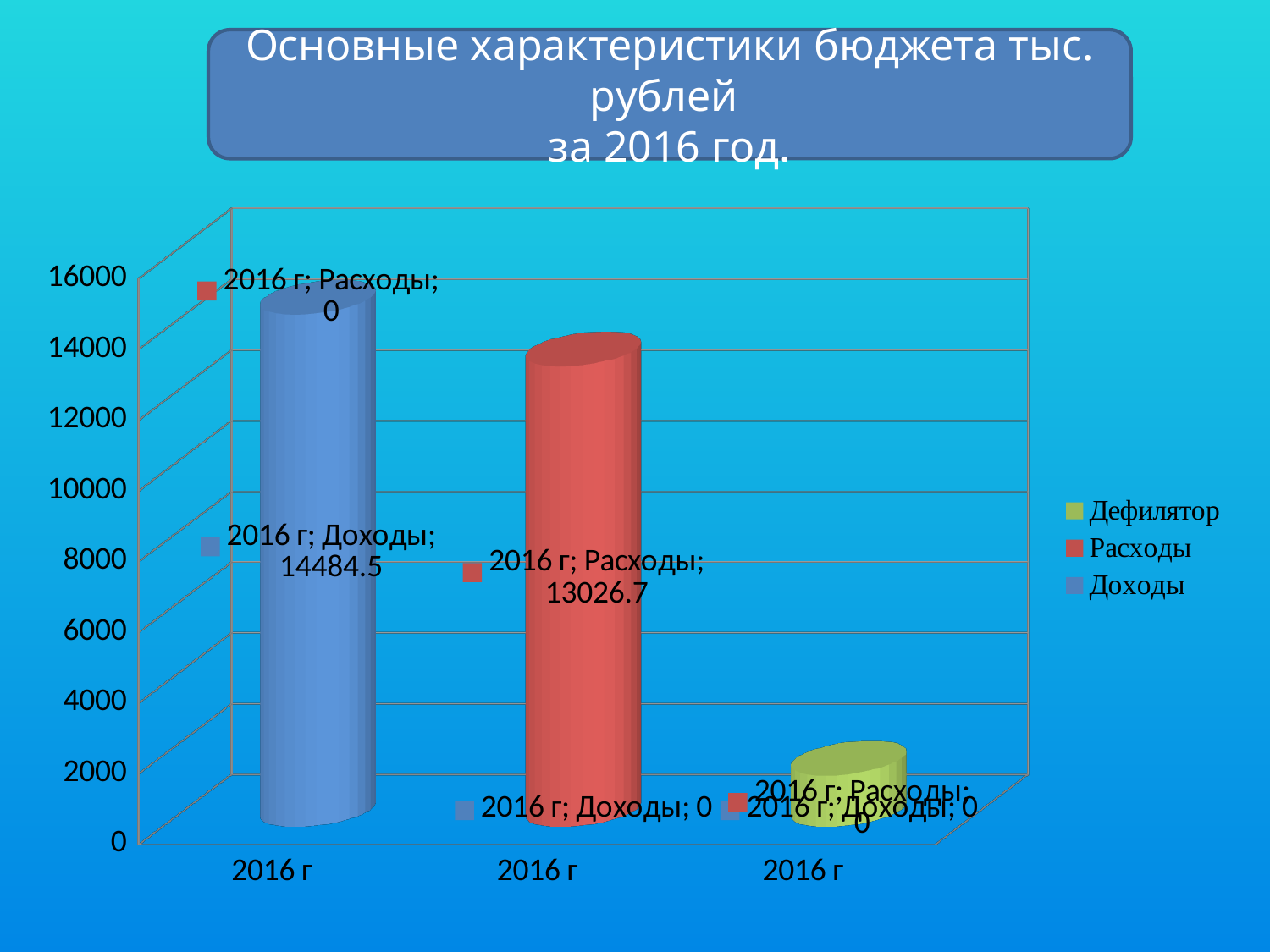
What is the difference between Доходы and Расходы for 2016 г? 1457.8 How many bars are plotted on the chart? 3 Is the value for Дефилятор greater or less than 2000? less How many series does the legend list? 3 What kind of chart is shown on the slide? bar chart Is the value for Расходы greater or less than 12000? greater Which is larger for 2016 г, Доходы or Расходы? Доходы What is the value of Расходы for 2016 г? 13026.7 Which series is shown in green in the legend? Дефилятор Which series has the lowest bar on the chart? Дефилятор What is the value of Доходы for 2016 г? 14484.5 Which series has the highest bar on the chart? Доходы